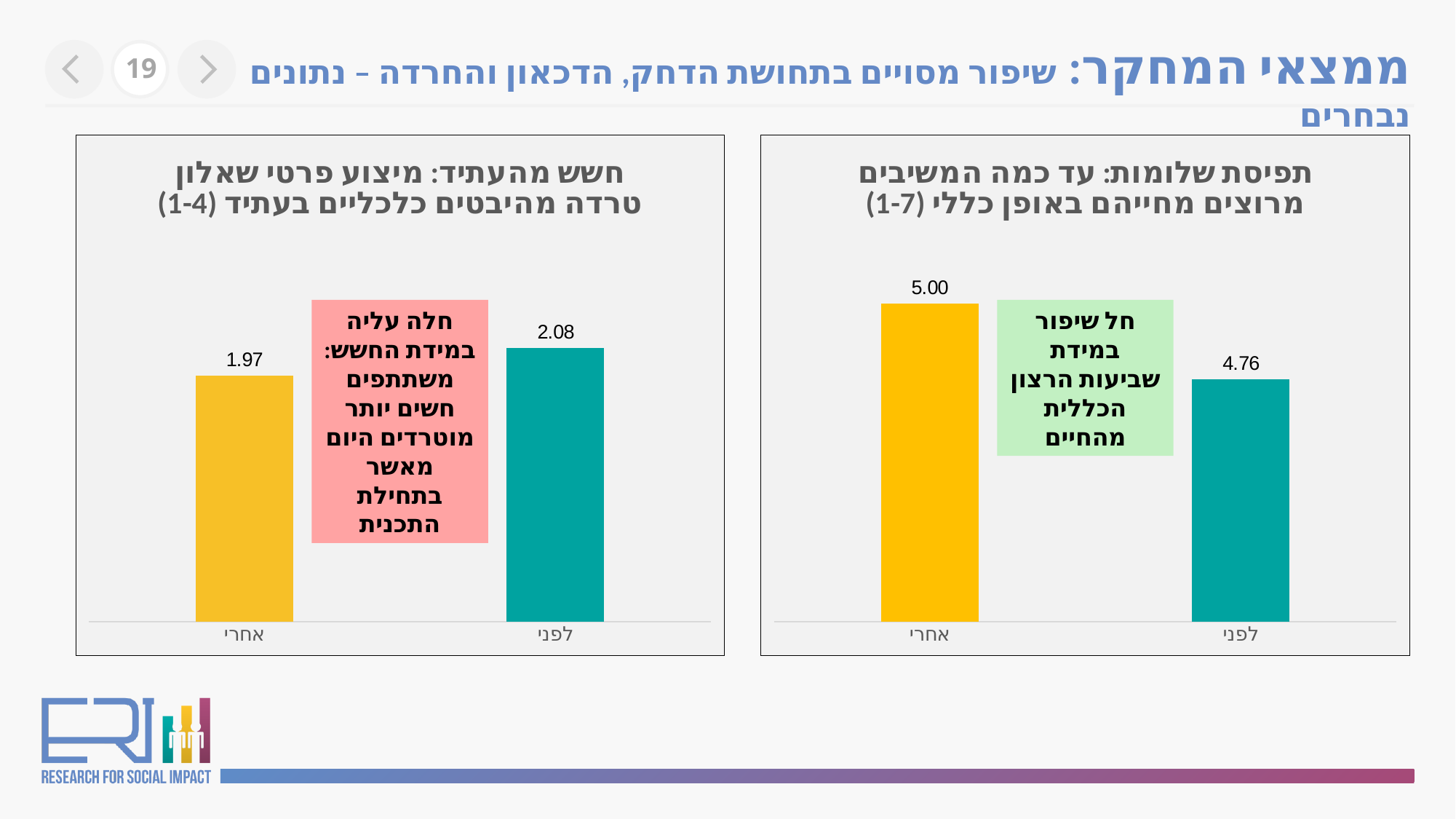
What kind of chart is the right chart (תפיסת שלומות)? bar chart In the right chart (תפיסת שלומות), what is the difference between the אחרי and לפני values? 0.24 In the left chart (חשש מהעתיד), what is the value for אחרי? 1.97 In the right chart (תפיסת שלומות), what is the value for אחרי? 5.00 How many bars are shown in the left chart (חשש מהעתיד)? 2 In the left chart (חשש מהעתיד), what is the difference between the לפני and אחרי values? 0.11 In the right chart (תפיסת שלומות), what colour is the אחרי bar? yellow In the left chart (חשש מהעתיד), which category has the higher value? לפני In the right chart (תפיסת שלומות), which category has the lower value? לפני In the left chart (חשש מהעתיד), what is the value for לפני? 2.08 In the right chart (תפיסת שלומות), is the value for אחרי larger or smaller than the value for לפני? larger In the right chart (תפיסת שלומות), what is the value for לפני? 4.76